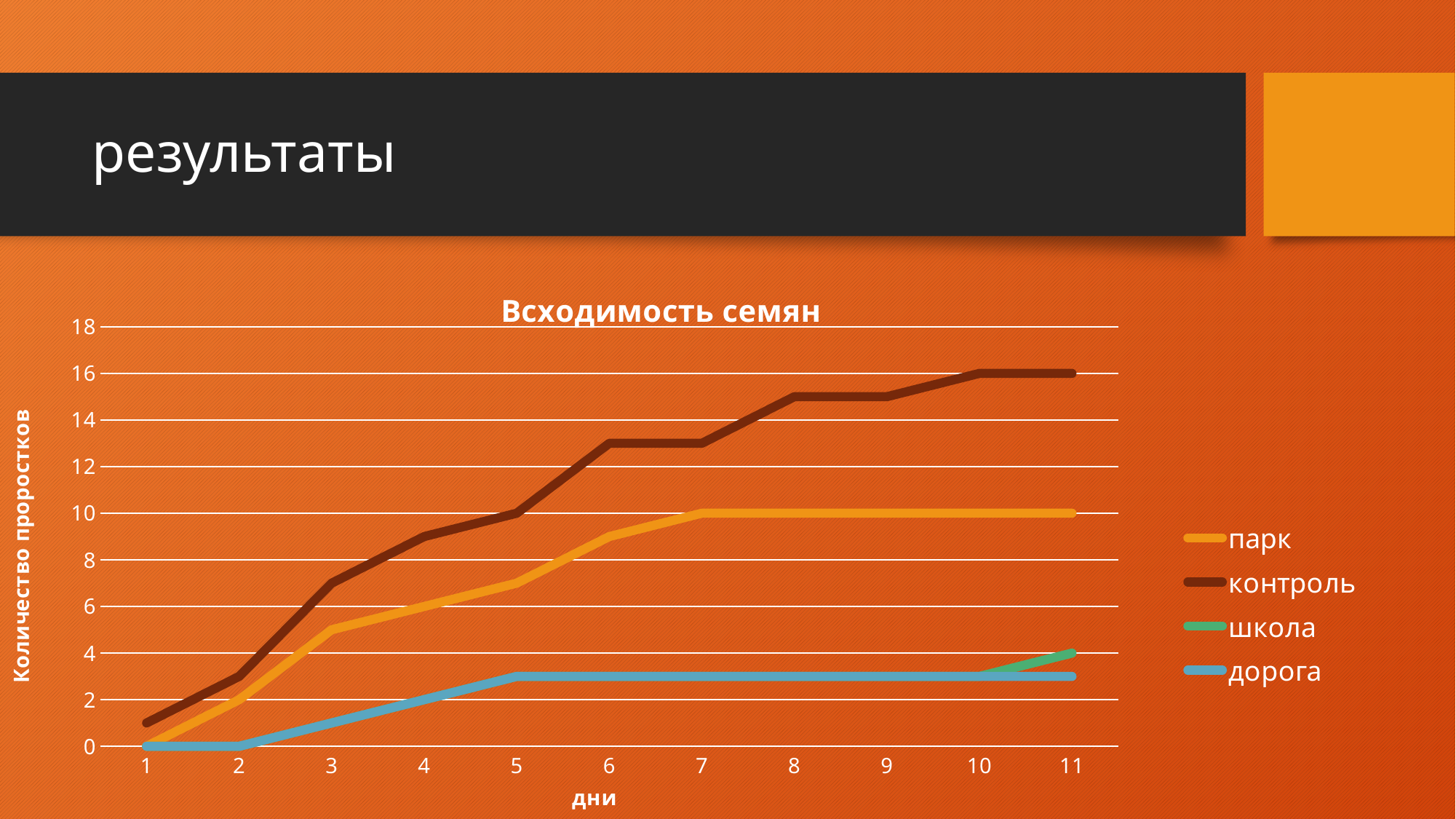
Which series has the highest value on day 11? контроль Which series has the lowest value on day 11? дорога What is the value for школа on day 11? 4 What is the value for контроль on day 11? 16 What kind of chart is shown on the slide? line chart What is the title of the chart? Всходимость семян What is the value for парк on day 11? 10 Does the контроль line rise or fall from day 1 to day 11? rise What is the difference between контроль and парк on day 11? 6 How many days are shown along the x axis? 11 Is the value for контроль on day 8 greater or less than 14? greater How many series does the legend list? 4